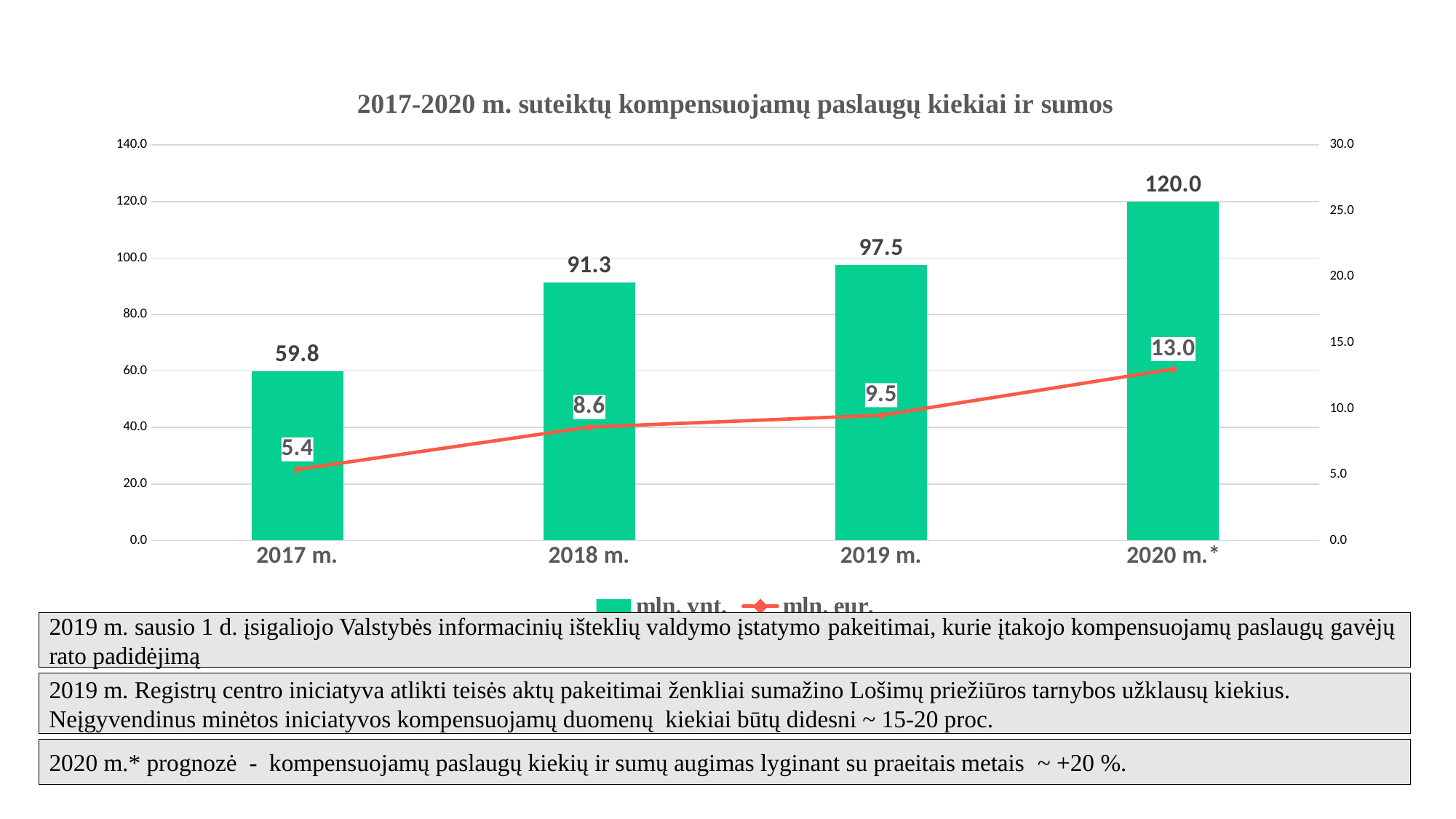
What is the mln. vnt. value for 2020 m.*? 120.0 How many years are shown on the x axis? 4 What is the mln. vnt. value for 2018 m.? 91.3 Which is larger, the mln. vnt. value for 2018 m. or for 2019 m.? 2019 m. Is the mln. vnt. value for 2017 m. greater or less than 80.0? less Which year has the highest mln. eur. value? 2020 m.* Do the mln. eur. values rise or fall from 2017 m. to 2020 m.*? rise What is the mln. eur. value for 2019 m.? 9.5 What is the difference between the mln. vnt. values for 2020 m.* and 2019 m.? 22.5 How many series does the legend list? 2 What is the difference between the mln. eur. values for 2018 m. and 2017 m.? 3.2 Which year has the lowest mln. vnt. value? 2017 m.